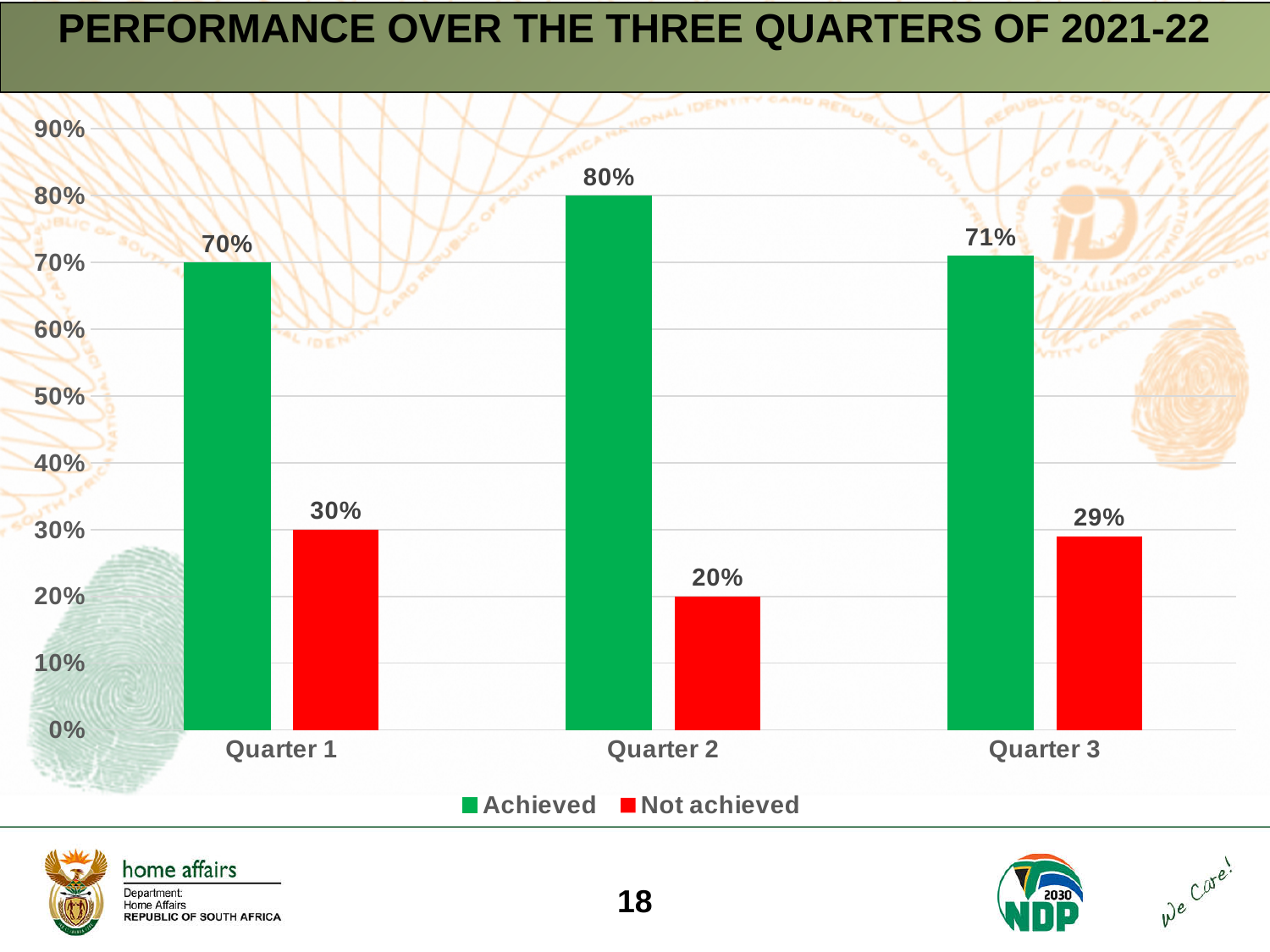
What is the Achieved value for Quarter 1? 70% What colour represents the Not achieved series? Red How many quarters are shown on the x axis? 3 What is the Not achieved value for Quarter 3? 29% How many series does the legend list? 2 What kind of chart is shown on the slide? Bar chart Which quarter has the lowest Not achieved value? Quarter 2 What is the difference between the Achieved and Not achieved values in Quarter 2? 60% Which quarter has the highest Achieved value? Quarter 2 What is the difference between the Achieved values for Quarter 2 and Quarter 3? 9% What is the Achieved value for Quarter 2? 80% Which is larger, the Not achieved value for Quarter 1 or for Quarter 3? Quarter 1